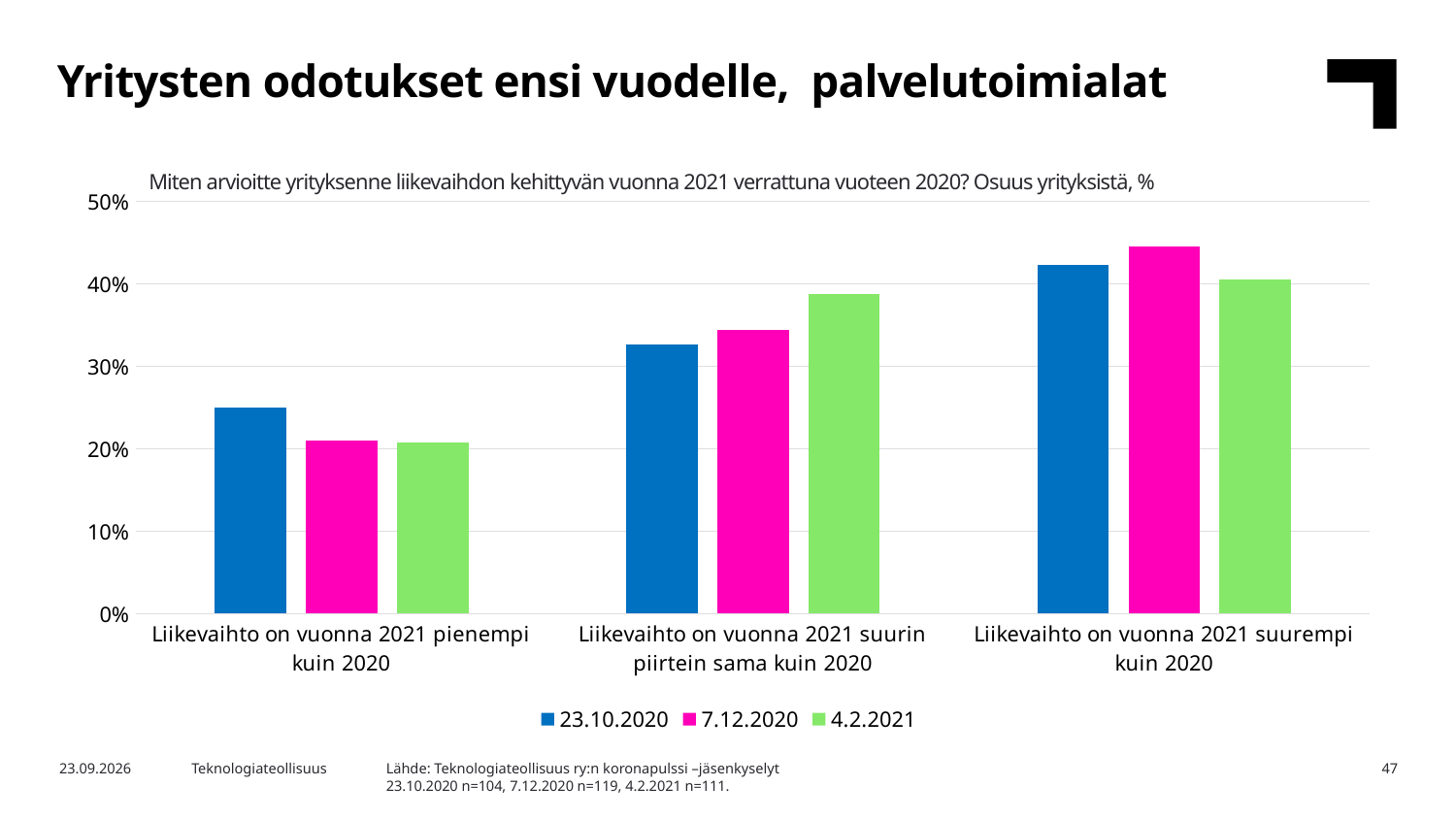
Which category has the lowest 23.10.2020 value? Liikevaihto on vuonna 2021 pienempi kuin 2020 Is the 7.12.2020 value for 'Liikevaihto on vuonna 2021 suurempi kuin 2020' greater or less than 40%? greater How many series does the legend list? 3 Which category has the highest 4.2.2021 value? Liikevaihto on vuonna 2021 suurempi kuin 2020 How many categories are shown on the x axis? 3 Is the 23.10.2020 value for 'Liikevaihto on vuonna 2021 pienempi kuin 2020' greater or less than 20%? greater What kind of chart is shown on the slide? Bar chart Which survey dates are listed in the legend? 23.10.2020, 7.12.2020, 4.2.2021 Is the 4.2.2021 value for 'Liikevaihto on vuonna 2021 suurin piirtein sama kuin 2020' greater or less than 30%? greater For 'Liikevaihto on vuonna 2021 suurin piirtein sama kuin 2020', which is larger: the 23.10.2020 value or the 4.2.2021 value? 4.2.2021 Do the 4.2.2021 values rise or fall moving from the left category to the right category? rise